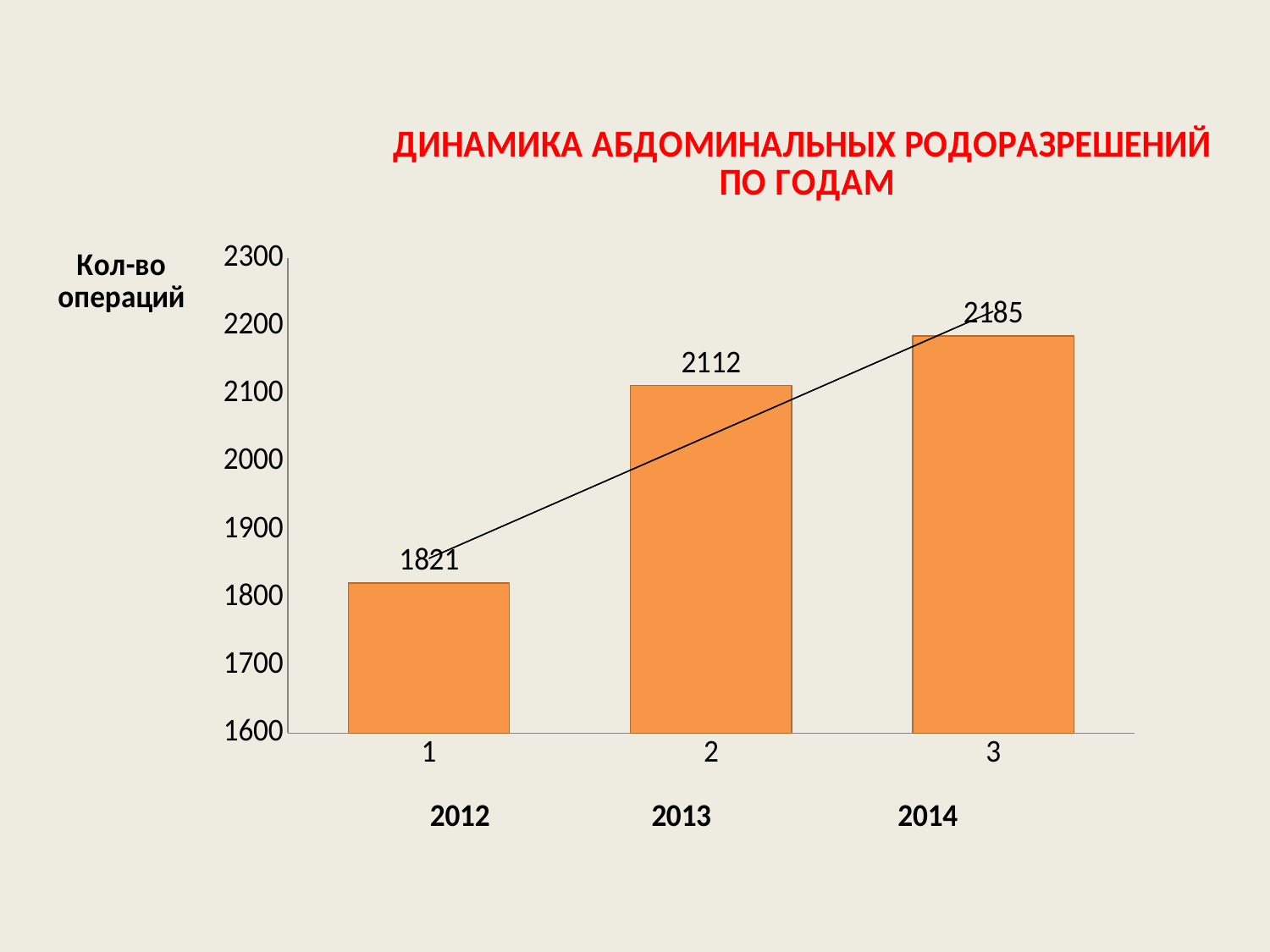
What is the difference between the number of operations in 2013 and 2012? 291 Which year has the highest number of operations? 2014 Is the value for 2012 greater or less than 1900? less How many bars are shown in the chart? 3 What is the number of operations for 2014? 2185 Do the values rise or fall from 2012 to 2014? rise What is the difference between the number of operations in 2014 and 2012? 364 What kind of chart is shown on the slide? bar chart What is the number of operations for 2012? 1821 What is the number of operations for 2013? 2112 Which is larger, the value for 2013 or the value for 2014? 2014 Which year has the lowest number of operations? 2012